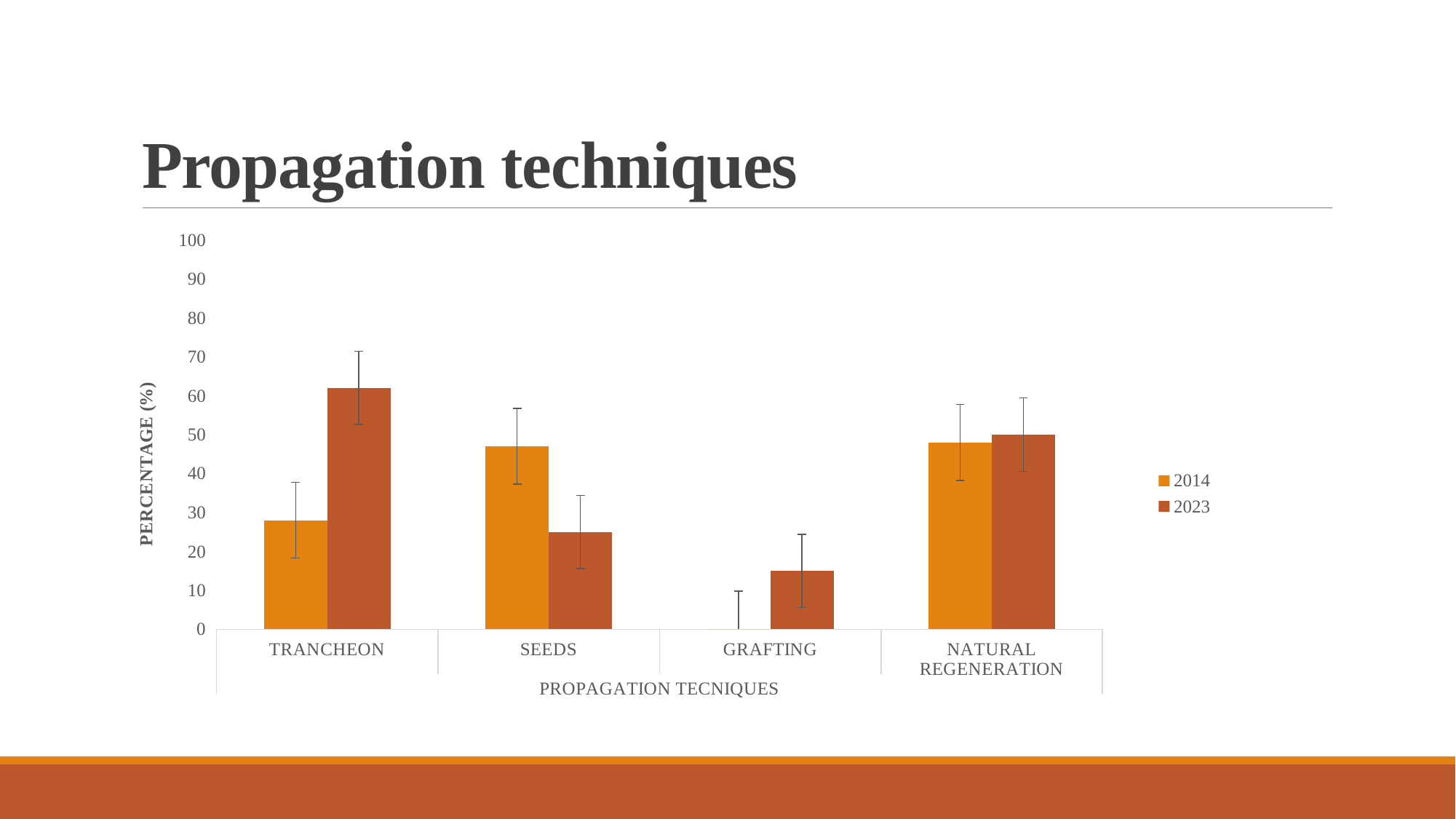
What kind of chart is shown on the slide? bar chart For SEEDS, which year has the larger value, 2014 or 2023? 2014 Is the 2023 value for GRAFTING greater or less than 20? less For TRANCHEON, which year has the larger value, 2014 or 2023? 2023 How many propagation technique categories are shown on the x axis? 4 Which propagation technique has the lowest value for 2014? GRAFTING How many series does the legend list? 2 Which propagation technique has the lowest value for 2023? GRAFTING Which propagation technique has the highest value for 2023? TRANCHEON Is the 2023 value for TRANCHEON greater or less than 50? greater What is the label of the y axis? PERCENTAGE (%) Is the 2014 value for SEEDS greater or less than 40? greater